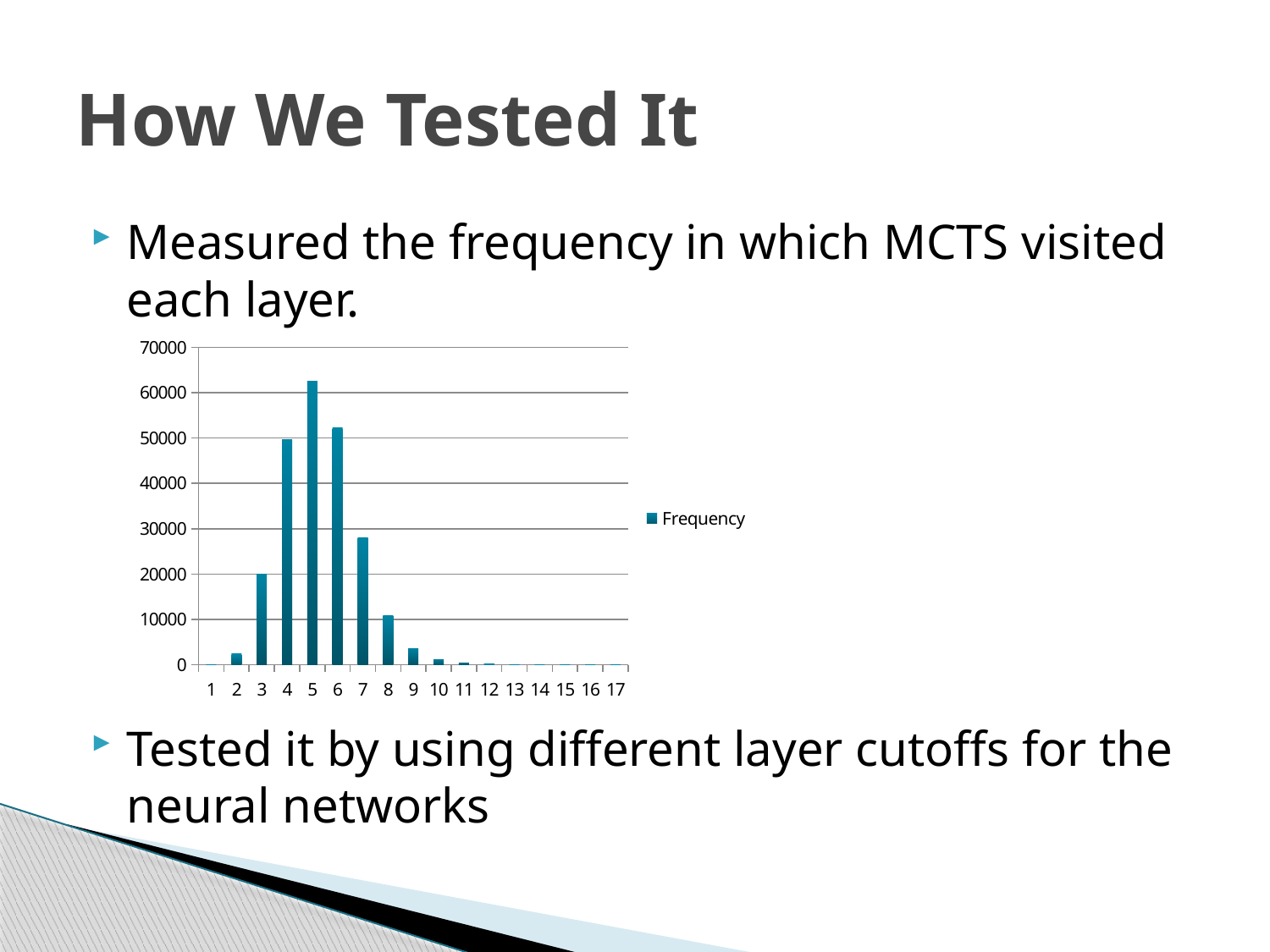
What is the name of the series shown in the legend? Frequency Is the Frequency value for category 3 greater or less than 30000? less Do the Frequency values rise or fall from category 5 to category 12? fall Which has a larger Frequency value, category 3 or category 7? 7 How many series does the chart's legend list? 1 Which has a larger Frequency value, category 6 or category 8? 6 Which category has the highest Frequency value? 5 How many categories are shown on the x axis of the chart? 17 Is the Frequency value for category 8 greater or less than 20000? less Is the Frequency value for category 5 greater or less than 60000? greater What kind of chart is shown on the slide? bar chart